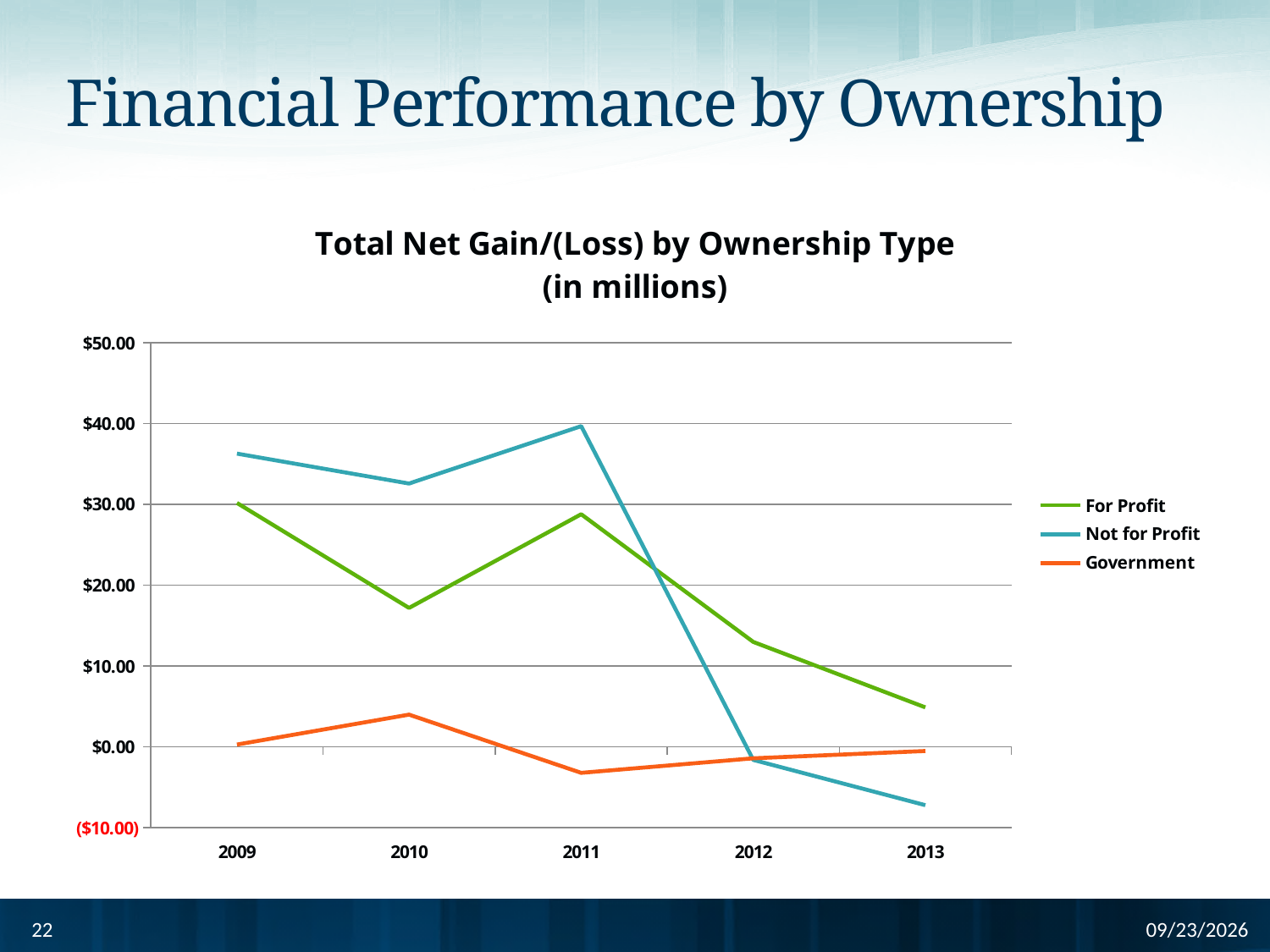
Is the value for Not for Profit in 2013 greater or less than $0.00? less What kind of chart is shown on the slide? line chart In 2009, which is larger: For Profit or Not for Profit? Not for Profit How many series does the legend list? 3 Does the For Profit line rise or fall from 2011 to 2013? fall How many years are shown on the x axis? 5 In which year is the For Profit line at its lowest? 2013 What is the title of the chart? Total Net Gain/(Loss) by Ownership Type (in millions) In which year is the Not for Profit line at its highest? 2011 Is the value for For Profit in 2010 greater or less than $20.00? less Is the value for Not for Profit in 2011 greater or less than $30.00? greater In which year is the Government line at its highest? 2010